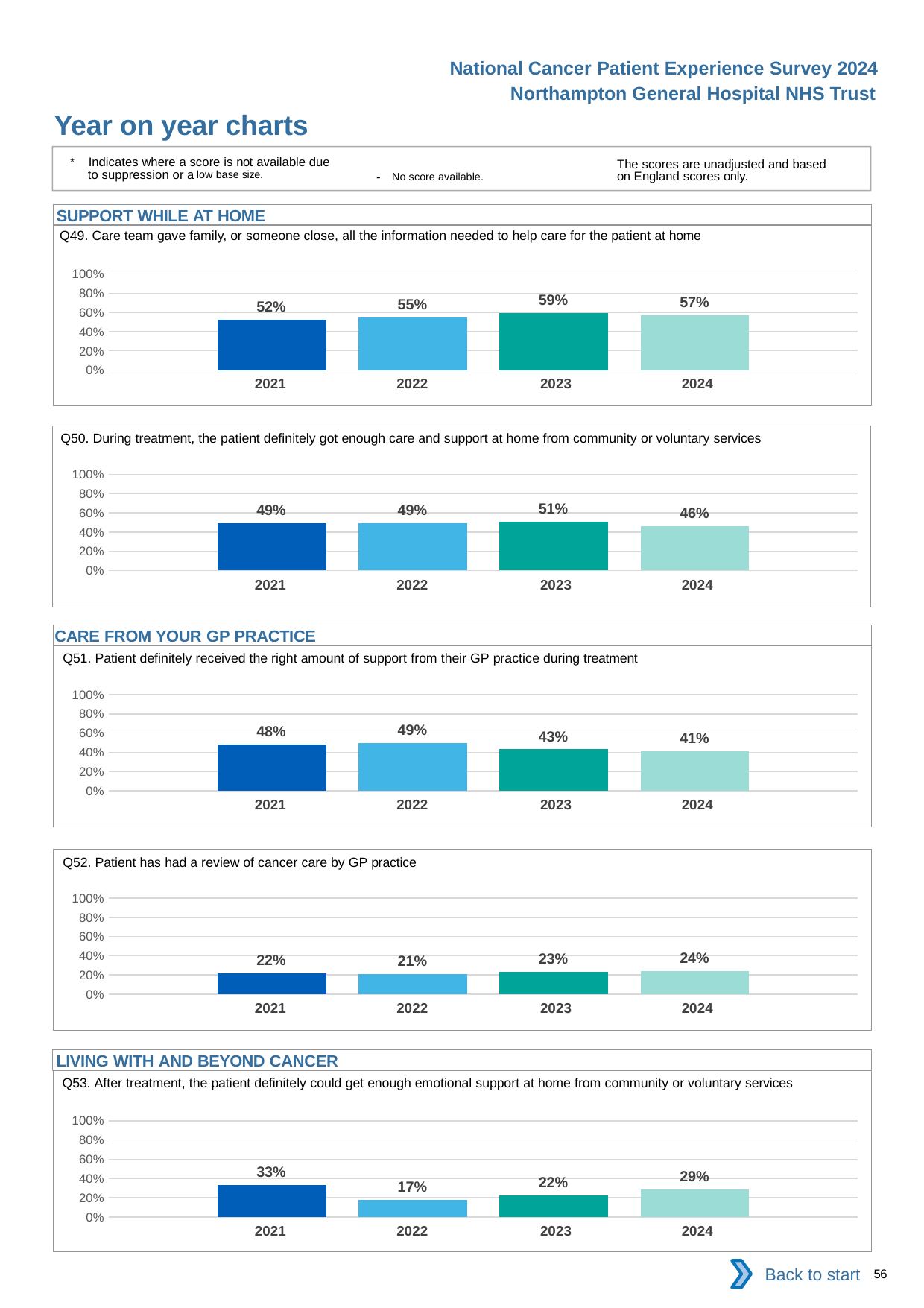
In the Q53 chart, which year has the lowest value? 2022 In the Q51 chart, which year has the highest value? 2022 In the Q52 chart, what is the value for 2021? 22% In the Q50 chart, what is the difference between the 2023 and 2024 values? 5 percentage points In the Q50 chart, what is the value for 2024? 46% How many years are shown in the Q53 chart? 4 In the Q53 chart, what is the difference between the 2021 and 2022 values? 16 percentage points In the Q49 chart, which year has the lowest value? 2021 In the Q49 chart, what is the value for 2023? 59% What type of chart is used for Q49? bar chart In the Q52 chart, is the value for 2024 greater or less than 40%? less In the Q51 chart, do the values rise or fall from 2022 to 2024? fall